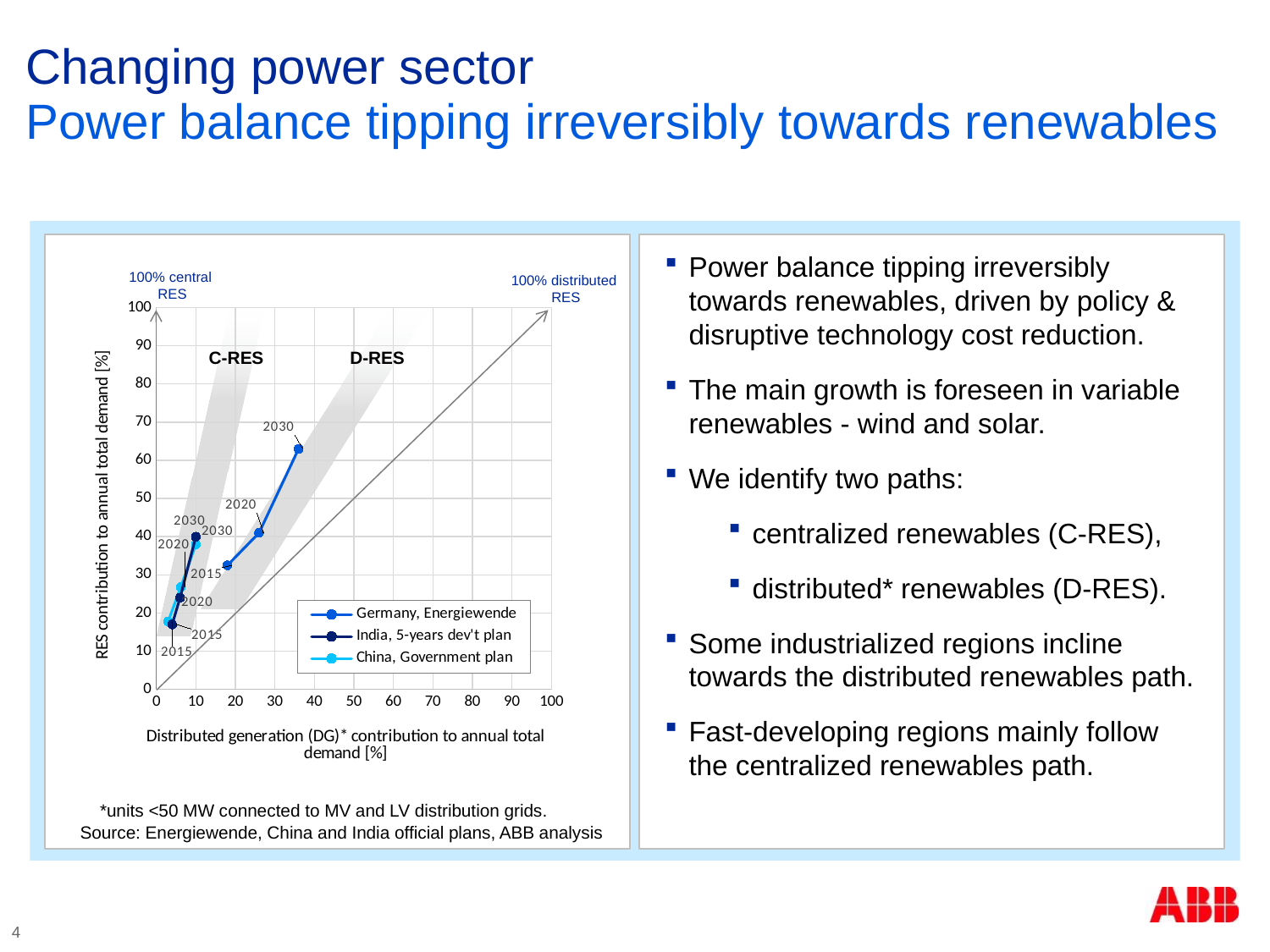
Is the RES contribution for Germany in 2015 greater or less than 40? less Which has a higher RES contribution in 2030, Germany or India? Germany What kind of chart is shown on the slide? line chart Does the RES contribution for Germany rise or fall from 2015 to 2030? rise How many series does the chart legend list? 3 What is the label of the vertical axis? RES contribution to annual total demand [%] Is the RES contribution for India in 2015 greater or less than 20? less Is the distributed generation contribution for Germany in 2030 greater or less than 50? less How many data points are plotted for the Germany, Energiewende series? 3 Which series reaches the highest RES contribution to annual total demand? Germany, Energiewende